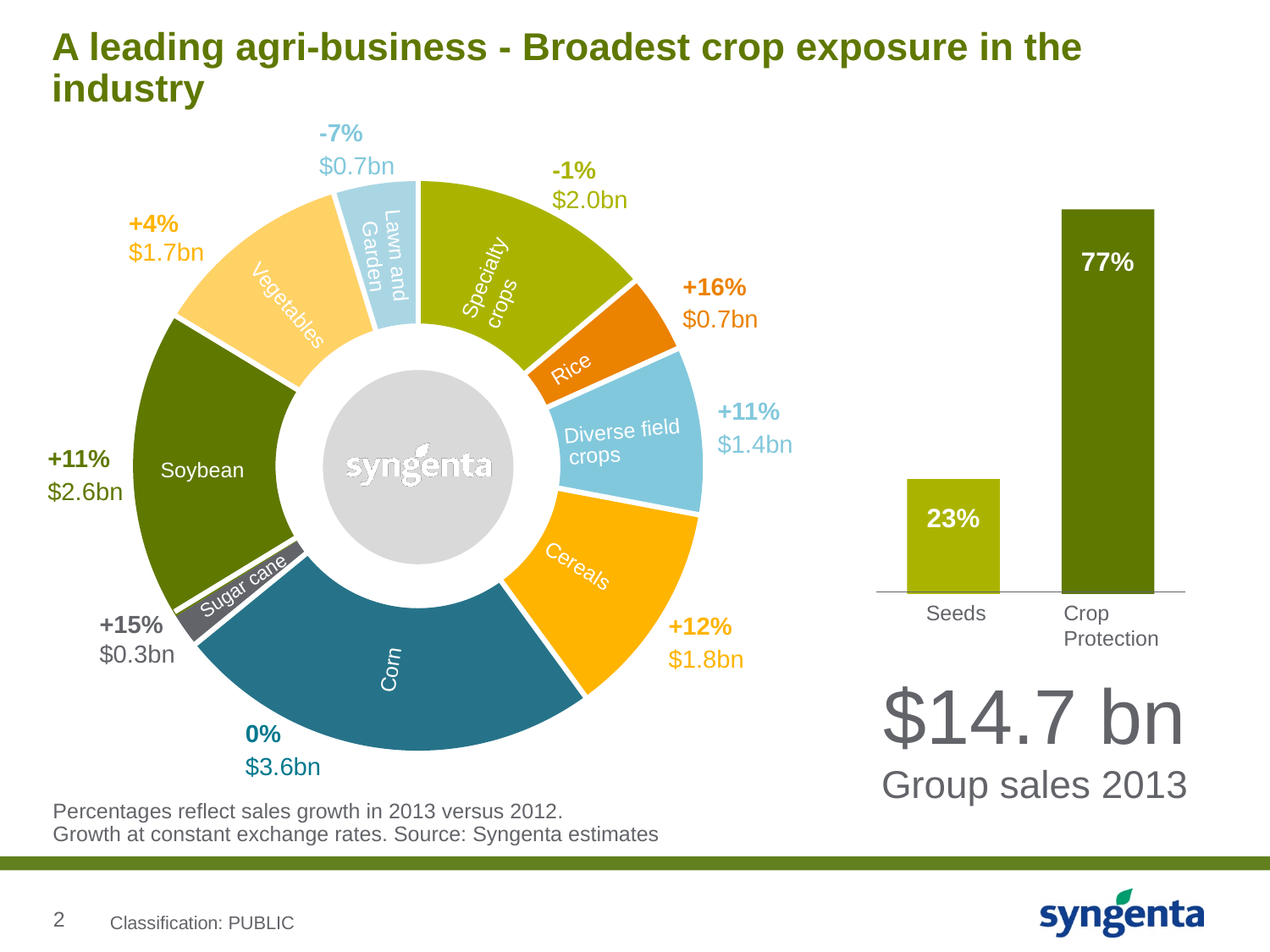
In the donut chart on the left, which crop segment has the highest sales value? Corn In the donut chart on the left, what is the sales growth percentage shown for Rice? +16% In the donut chart on the left, which crop segment shows the lowest growth percentage? Lawn and Garden In the bar chart on the right, what percentage is shown for Crop Protection? 77% In the bar chart on the right, what is the difference between the Crop Protection and Seeds percentages? 54 percentage points What group sales figure for 2013 is shown on the slide? $14.7 bn How many crop segments are shown in the donut chart on the left? 9 In the donut chart on the left, which crop segment has the lowest sales value? Sugar cane What kind of chart is the chart on the right showing Seeds and Crop Protection? Bar chart In the donut chart on the left, what is the difference in sales between Soybean and Cereals? $0.8bn In the donut chart on the left, which has higher sales, Vegetables or Diverse field crops? Vegetables In the donut chart on the left, what are the 2013 sales for Corn? $3.6bn